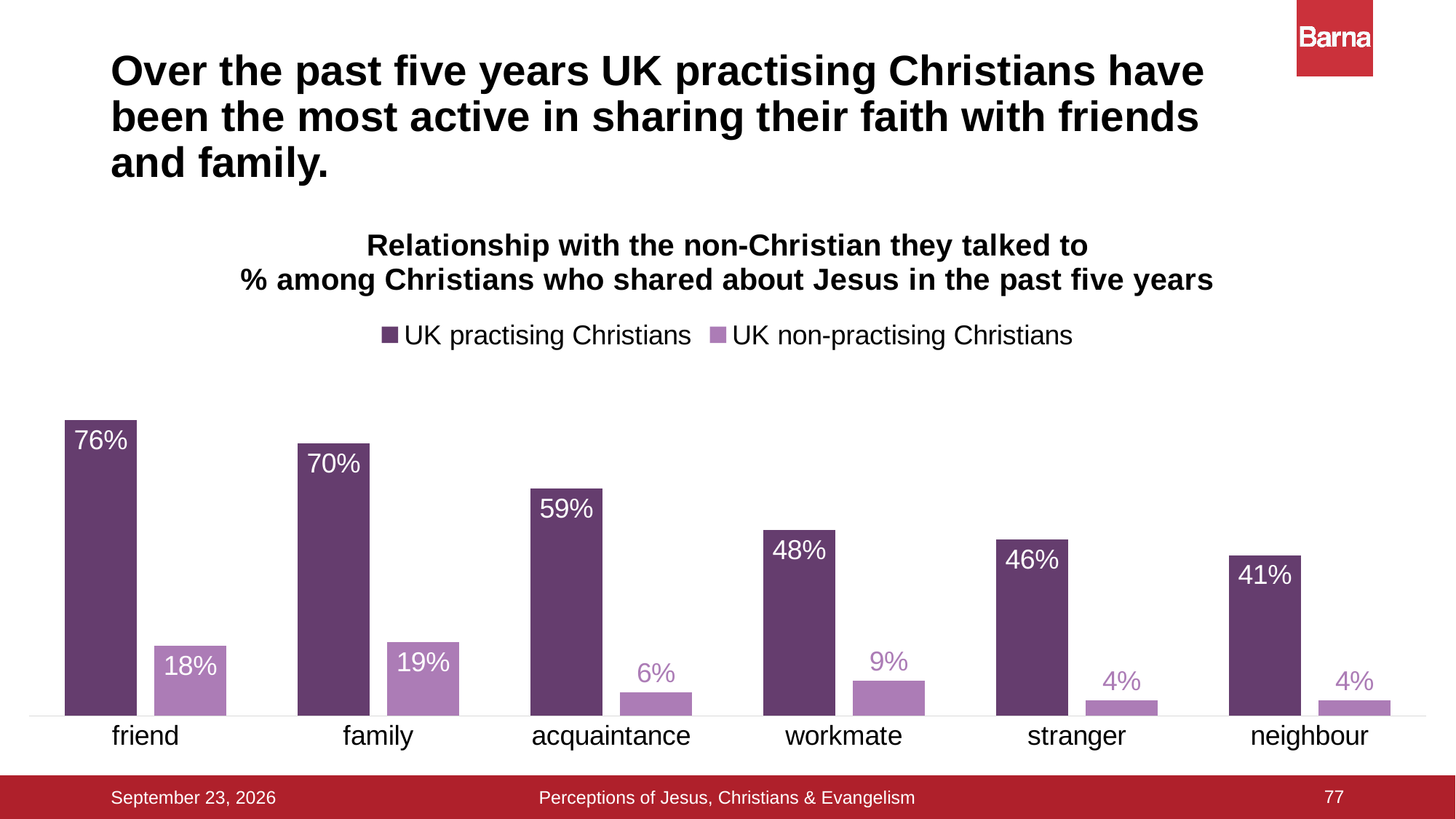
Which category has the lowest value for UK practising Christians? neighbour Which category has the highest value for UK non-practising Christians? family What kind of chart is shown on the slide? bar chart What percentage of UK practising Christians shared about Jesus with a friend? 76% What percentage of UK practising Christians talked to a workmate? 48% What is the difference between UK practising and UK non-practising Christians in the acquaintance category? 53% What is the difference between the friend and family values for UK practising Christians? 6% How many relationship categories are shown on the x axis? 6 Which is larger for UK non-practising Christians: workmate or acquaintance? workmate What is the value for UK non-practising Christians in the family category? 19% Which category has the highest value for UK practising Christians? friend How many series does the legend list? 2